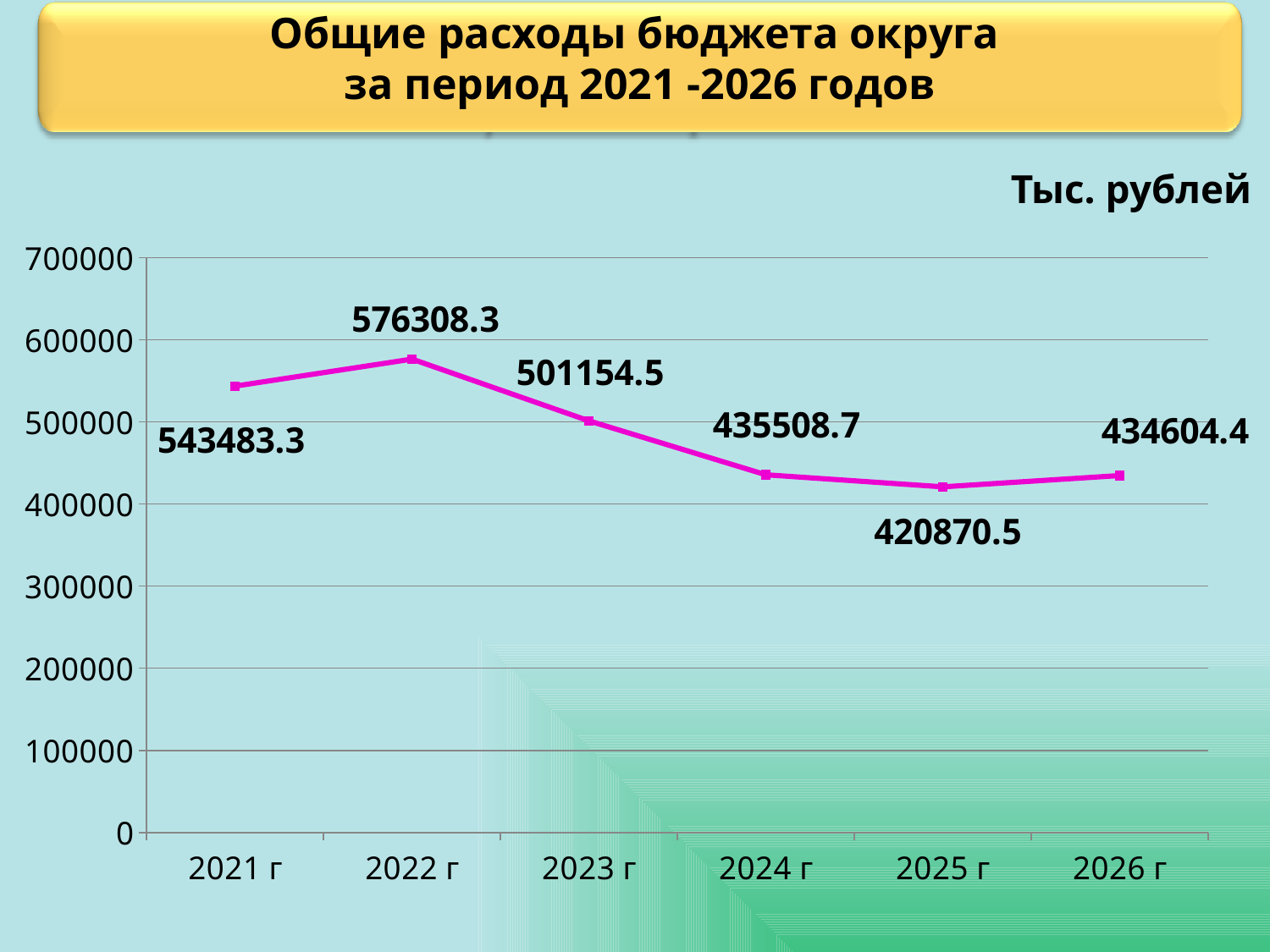
Which year has the lowest value? 2025 г How many years are plotted on the chart? 6 What is the value for 2025 г? 420870.5 Is the value for 2021 г greater or less than 500000? greater What is the difference between the values for 2022 г and 2023 г? 75153.8 What is the difference between the values for 2022 г and 2021 г? 32825.0 Which year has the highest value? 2022 г What kind of chart is shown on the slide? line chart What is the value for 2026 г? 434604.4 What is the value for 2022 г? 576308.3 Which is larger, the value for 2024 г or the value for 2026 г? 2024 г Do the values rise or fall from 2022 г to 2025 г? fall